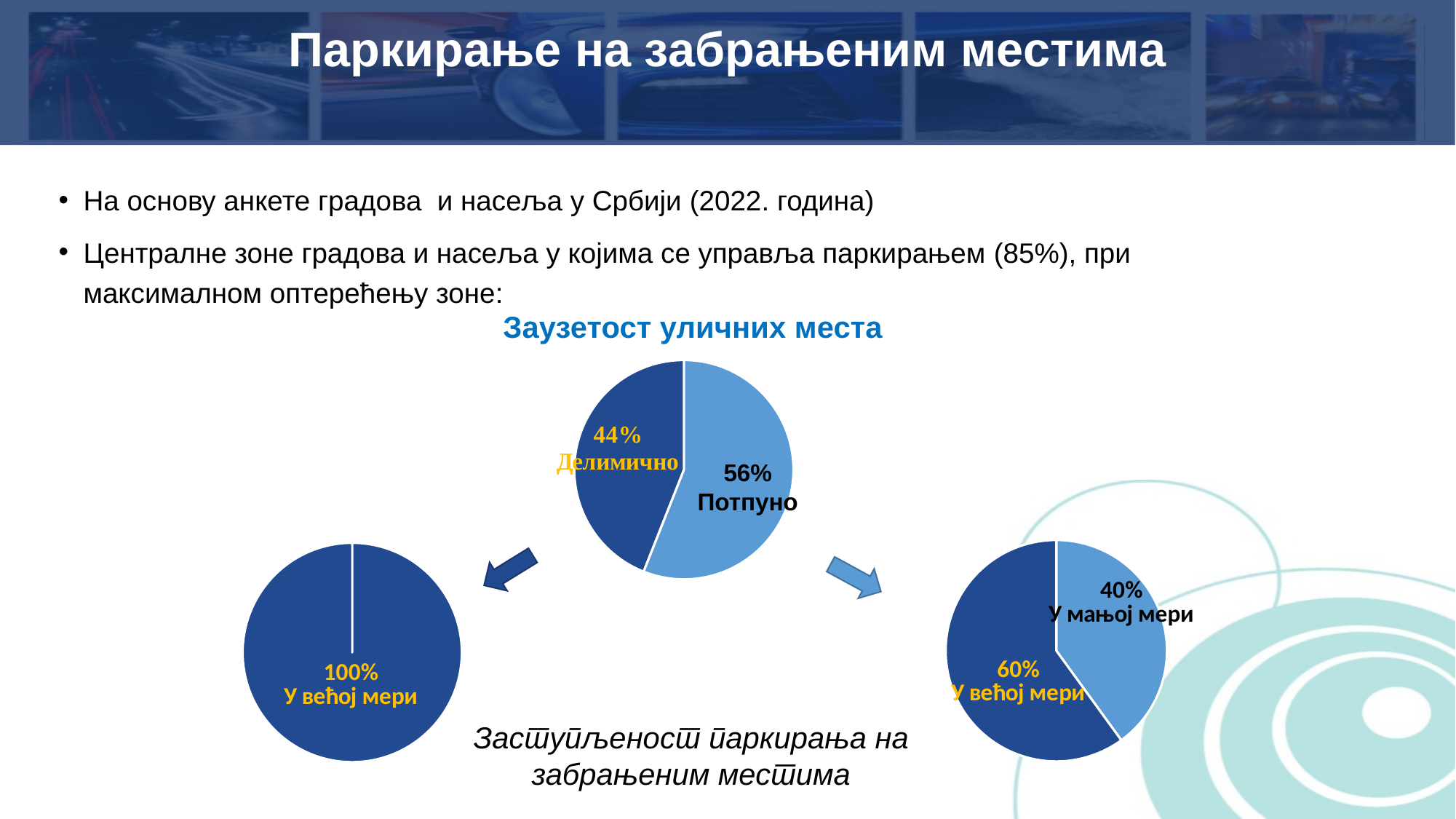
In the bottom-right pie chart, what is the difference between the "У већој мери" and "У мањој мери" shares? 20% In the bottom-left pie chart, what share is labelled "У већој мери"? 100% How many slices does the top pie chart titled "Заузетост уличних места" have? 2 In the top pie chart titled "Заузетост уличних места", what share is labelled "Потпуно"? 56% In the bottom-right pie chart, what share is labelled "У већој мери"? 60% How many pie charts are shown on the slide? 3 In the top pie chart titled "Заузетост уличних места", which slice is larger, "Потпуно" or "Делимично"? Потпуно In the bottom-right pie chart, what share is labelled "У мањој мери"? 40% In the top pie chart titled "Заузетост уличних места", what share is labelled "Делимично"? 44% In the top pie chart titled "Заузетост уличних места", what is the difference between the "Потпуно" and "Делимично" shares? 12% In the bottom-right pie chart, which slice is larger, "У већој мери" or "У мањој мери"? У већој мери What kind of chart is the chart titled "Заузетост уличних места"? Pie chart